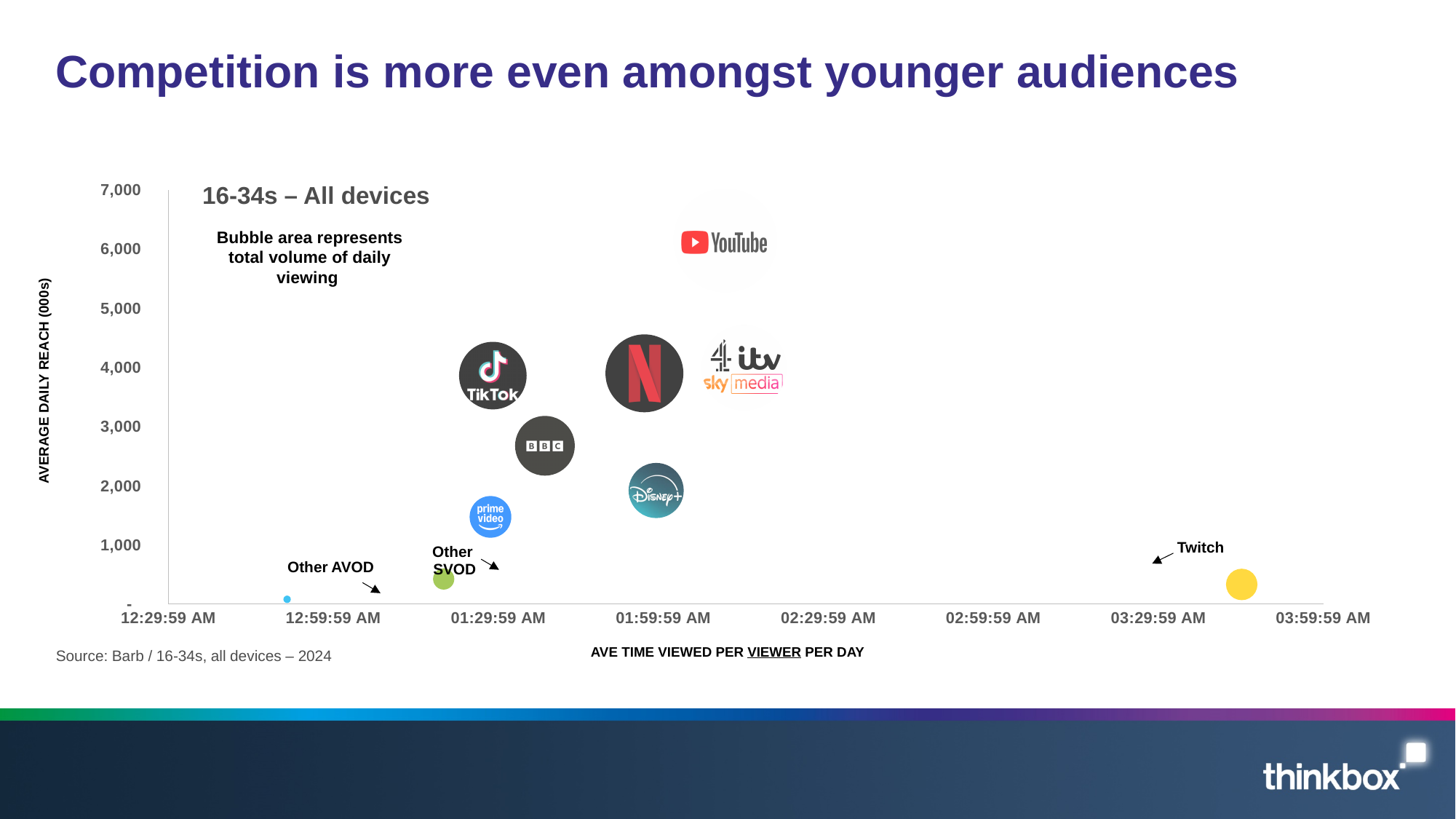
Is the average daily reach for Twitch greater or less than 1,000? less Which service has the highest average time viewed per viewer per day? Twitch What is the title of the chart? 16-34s – All devices What kind of chart is shown on the slide? Bubble chart Which service has the lowest average time viewed per viewer per day? Other AVOD Which service has the highest average daily reach? YouTube Is the average daily reach for TikTok greater or less than 3,000? greater Which has the higher average time viewed per viewer per day, Twitch or Disney+? Twitch Which has the higher average daily reach, YouTube or Netflix? YouTube Is the average daily reach for YouTube greater or less than 5,000? greater According to the chart's note, what does the bubble area represent? Total volume of daily viewing Which service has the lowest average daily reach? Other AVOD